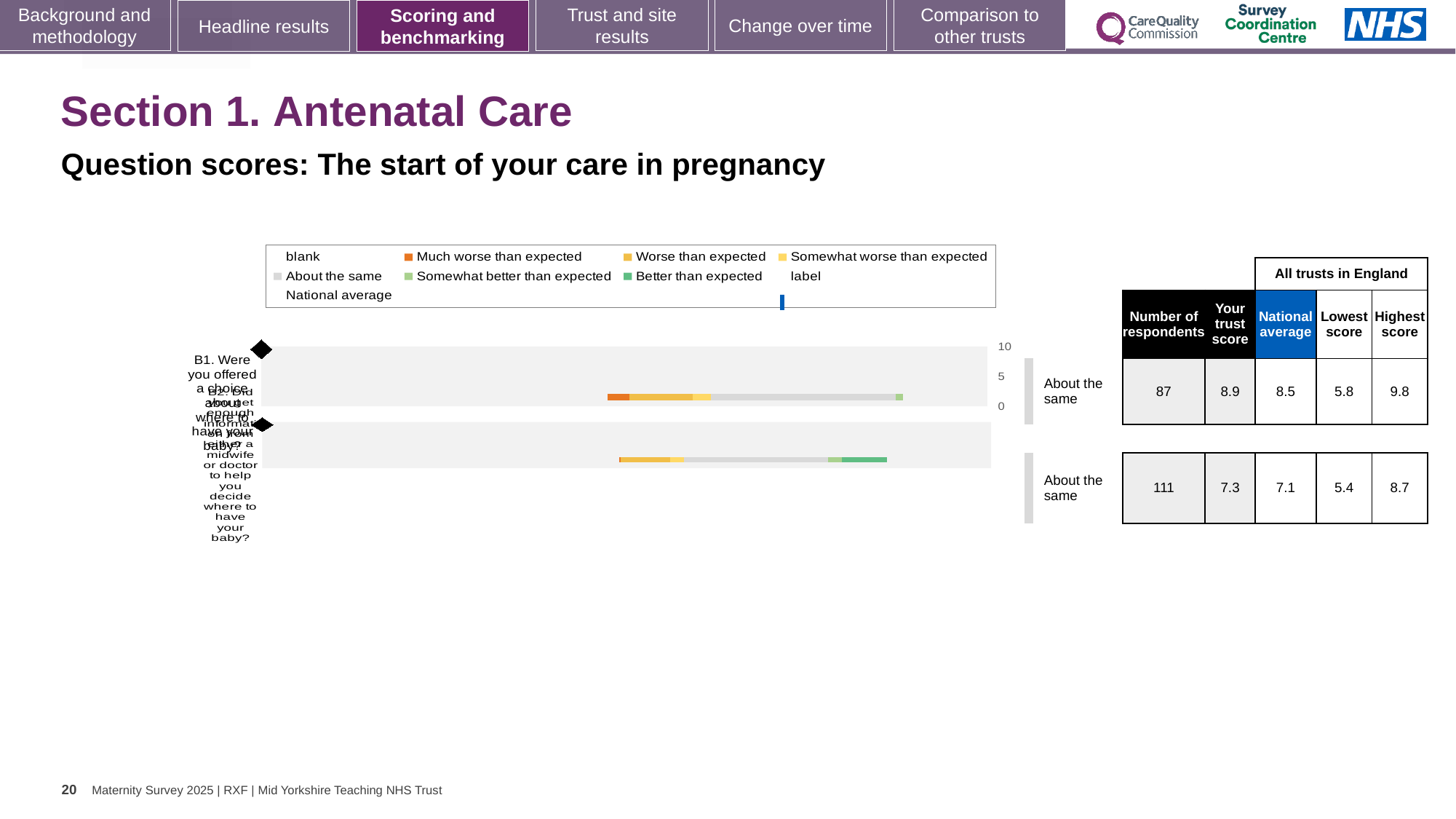
How many more respondents answered question B2 than question B1? 24 For question B1, which is larger: the trust score or the national average? trust score How many questions (categories) are plotted on the chart? 2 What is the highest score across all trusts in England for question B1? 9.8 What is the lowest score across all trusts in England for question B2? 5.4 What is the number of respondents for question B1? 87 What kind of chart is shown on the slide? bar chart Which question has the larger number of respondents, B1 or B2? B2 What is the trust score for question B1? 8.9 What is the national average for question B2? 7.1 What is the difference between the highest score and the lowest score for question B1? 4.0 What benchmark category is shown next to the bar for question B1? About the same